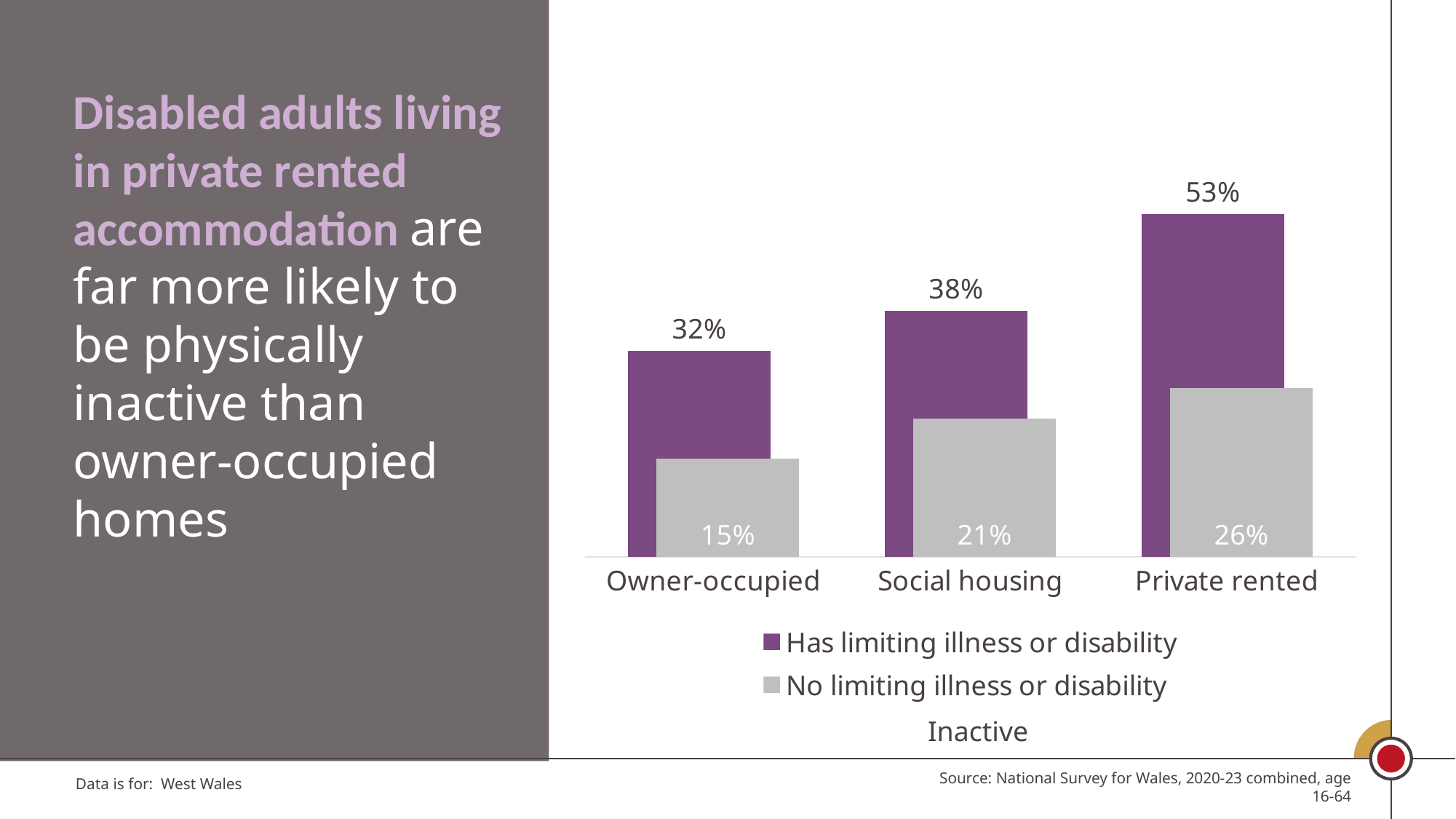
Which housing type has the highest inactive percentage for people with a limiting illness or disability? Private rented How many housing categories are shown on the x axis? 3 What is the difference between the 'Has limiting illness or disability' and 'No limiting illness or disability' values for private rented accommodation? 27 percentage points How much higher is the inactive percentage for disabled adults in private rented accommodation than in owner-occupied homes? 21 percentage points What percentage of people with a limiting illness or disability living in private rented accommodation are inactive? 53% Which is larger: the 'No limiting illness or disability' value for social housing or for private rented? Private rented What kind of chart is shown on the slide? Bar chart What is the value for 'Has limiting illness or disability' in social housing? 38% Which housing type has the lowest inactive percentage for people with no limiting illness or disability? Owner-occupied Do the 'Has limiting illness or disability' values rise or fall from Owner-occupied to Private rented? Rise How many series does the legend list? 2 What is the inactive percentage for people with no limiting illness or disability in owner-occupied homes? 15%